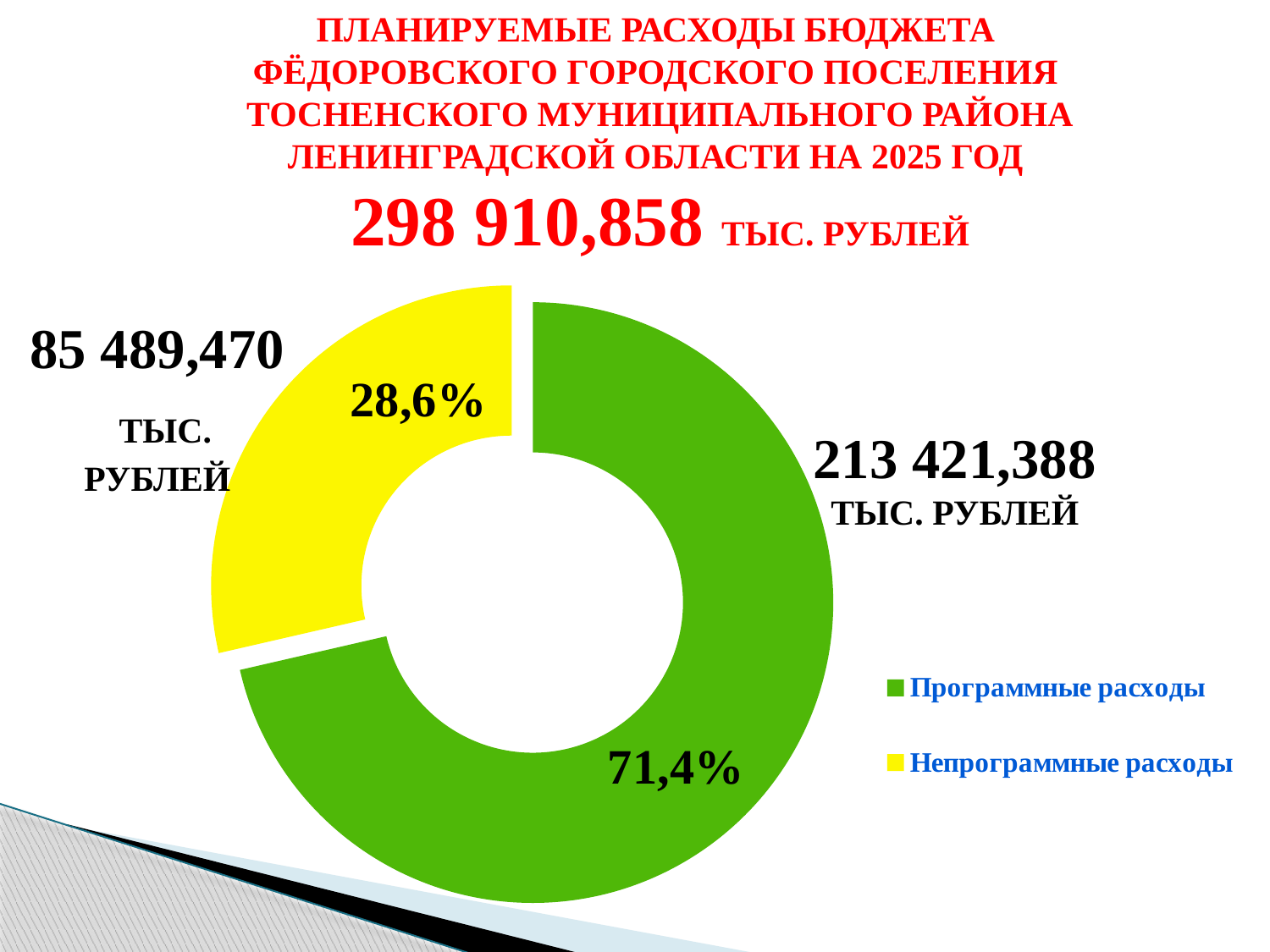
What is the value for Непрограммные расходы in thousand rubles? 85 489,470 What share of the pie does Программные расходы take? 71,4% What kind of chart is shown on the slide? Pie chart (doughnut) What colour is the slice for Непрограммные расходы? Yellow Which category has the smallest slice? Непрограммные расходы Which is larger, Программные расходы or Непрограммные расходы? Программные расходы What is the total planned budget expenditure shown on the slide, in thousand rubles? 298 910,858 What is the value for Программные расходы in thousand rubles? 213 421,388 Which category has the largest slice? Программные расходы What share of the pie does Непрограммные расходы take? 28,6% What is the difference in percentage points between the Программные расходы and Непрограммные расходы shares? 42,8 How many categories does the pie chart show? 2